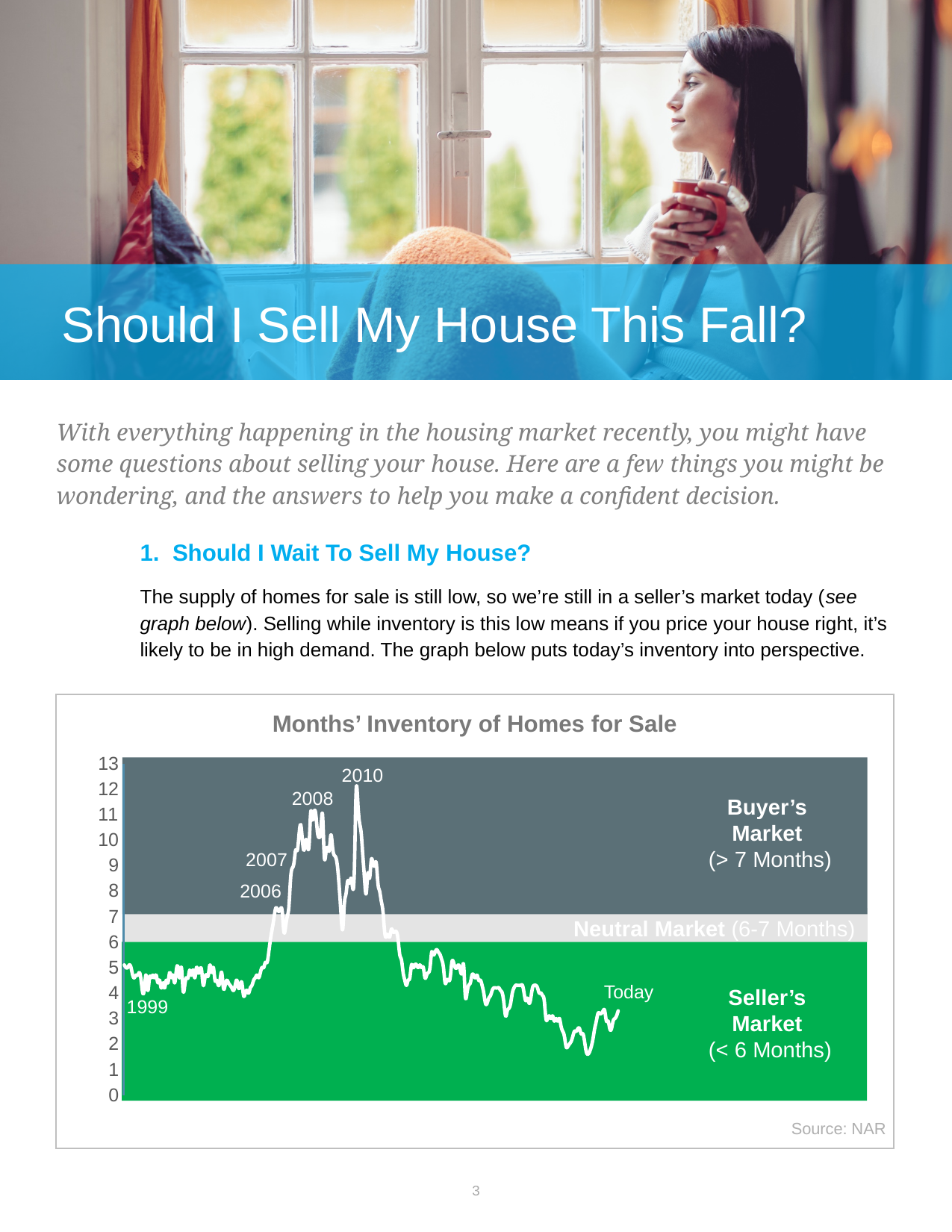
Is the value labeled Today greater or less than 6? less Which market zone does the Today point fall in? Seller's Market What is the highest value shown on the y axis? 13 What is the title of the chart? Months' Inventory of Homes for Sale Which is larger, the value at 2008 or the value labeled Today? 2008 Does the inventory rise or fall from the 2010 peak to Today? fall Is the value at 2008 greater or less than 9? greater Of the labeled years on the chart, which has the highest inventory value? 2010 Is the value at the 2010 peak greater or less than 10? greater What kind of chart is shown on the slide? line chart